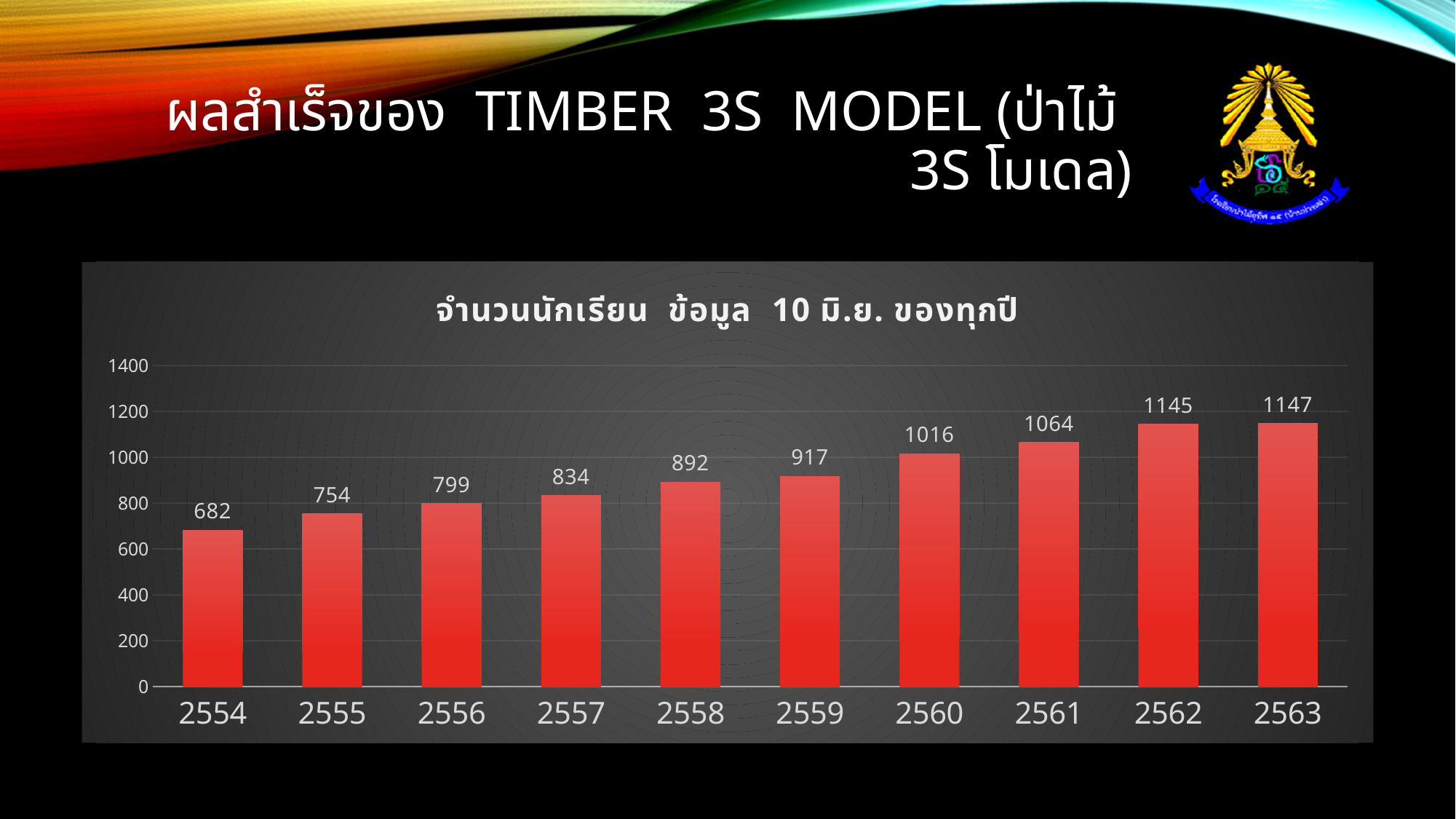
What is the value for 2554? 682 How many years are shown on the x axis? 10 What is the value for 2558? 892 Is the value for 2556 greater or less than 1000? less Which is larger, the value for 2557 or the value for 2559? 2559 Which year has the lowest value? 2554 Do the values rise or fall from 2554 to 2563? rise What is the value for 2560? 1016 What is the difference between the values for 2561 and 2560? 48 Which year has the highest value? 2563 What is the difference between the values for 2563 and 2554? 465 What kind of chart is shown on the slide? bar chart